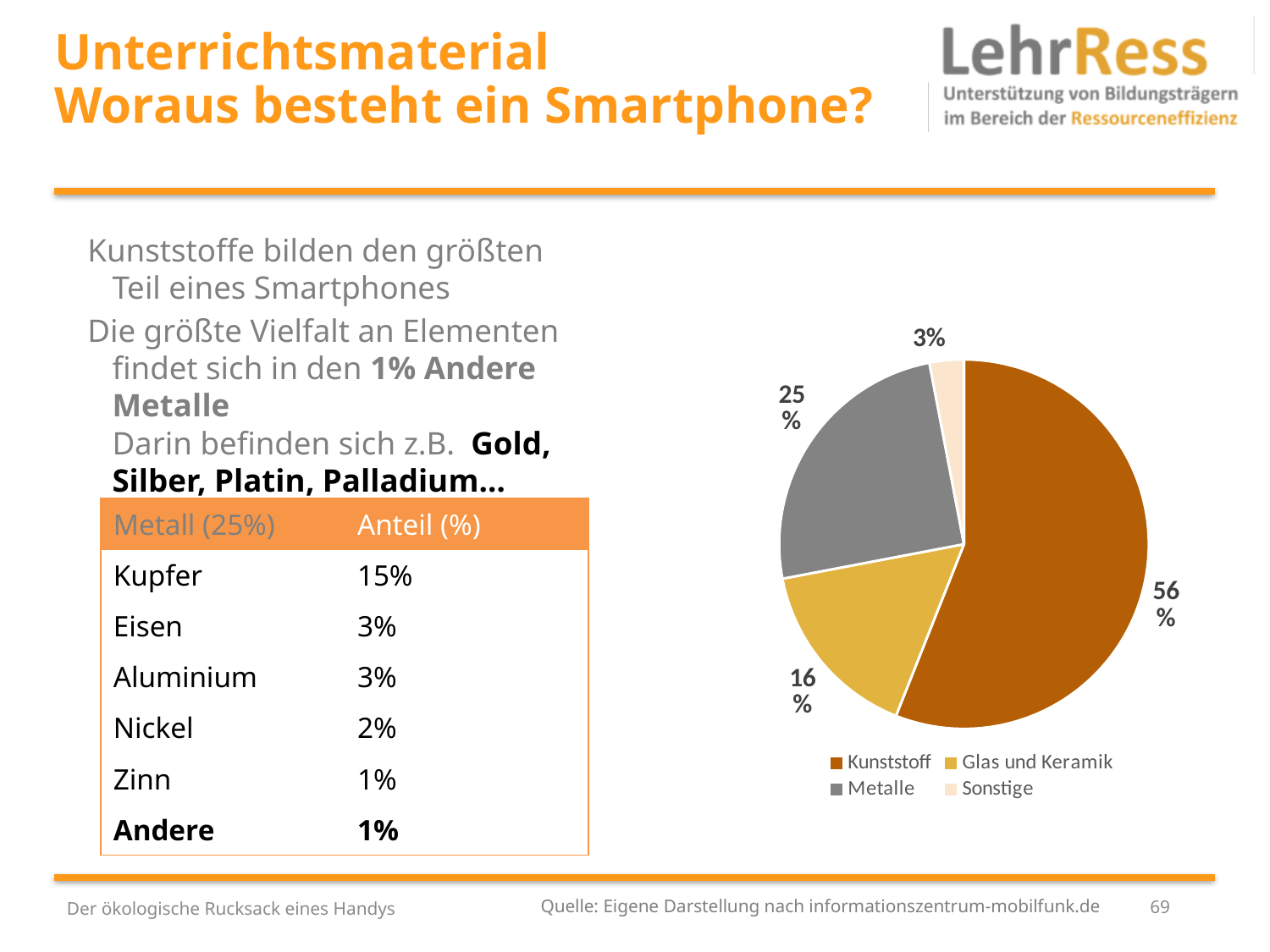
What share of the pie does Kunststoff have? 56% Which legend entry is shown in grey? Metalle What share of the pie does Sonstige have? 3% Which is larger, the slice for Metalle or the slice for Glas und Keramik? Metalle Which category has the smallest slice of the pie? Sonstige What kind of chart is shown on the slide? pie chart What is the difference in percentage points between Kunststoff and Metalle? 31 What share of the pie does Glas und Keramik have? 16% Which category has the largest slice of the pie? Kunststoff What share of the pie does Metalle have? 25% How many entries does the legend of the pie chart list? 4 How many slices does the pie chart have? 4